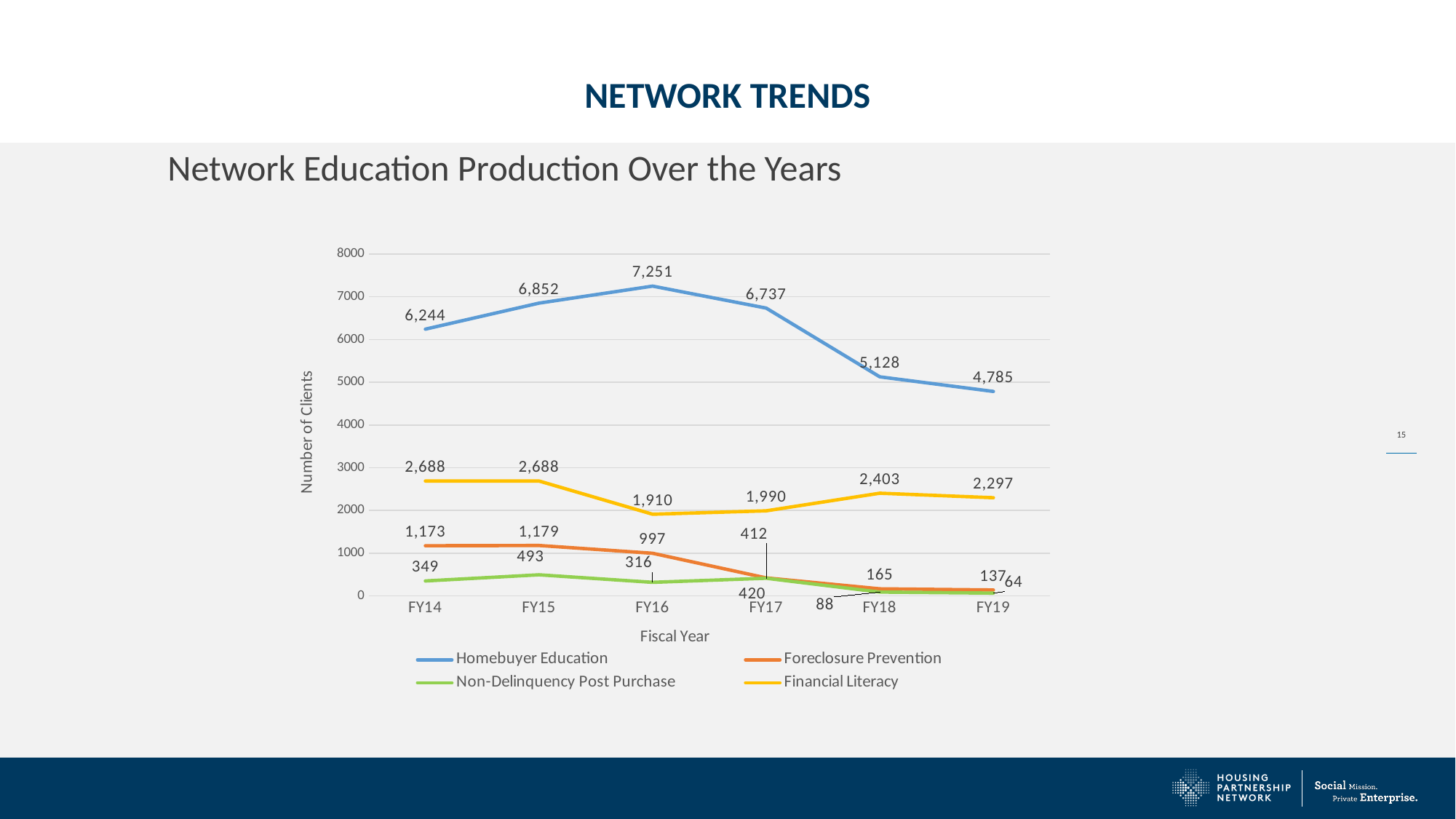
What is the Foreclosure Prevention value for FY16? 997 Does Homebuyer Education rise or fall from FY16 to FY19? Fall What is the label on the y axis? Number of Clients How many series does the legend list? 4 In which fiscal year is Homebuyer Education highest? FY16 What is the Financial Literacy value for FY18? 2,403 What is the Homebuyer Education value for FY16? 7,251 In which fiscal year is Financial Literacy lowest? FY16 Which is larger in FY14, Financial Literacy or Foreclosure Prevention? Financial Literacy What type of chart is shown on the slide? Line chart What is the difference between the Homebuyer Education values for FY14 and FY19? 1,459 How many fiscal years are plotted on the x axis? 6